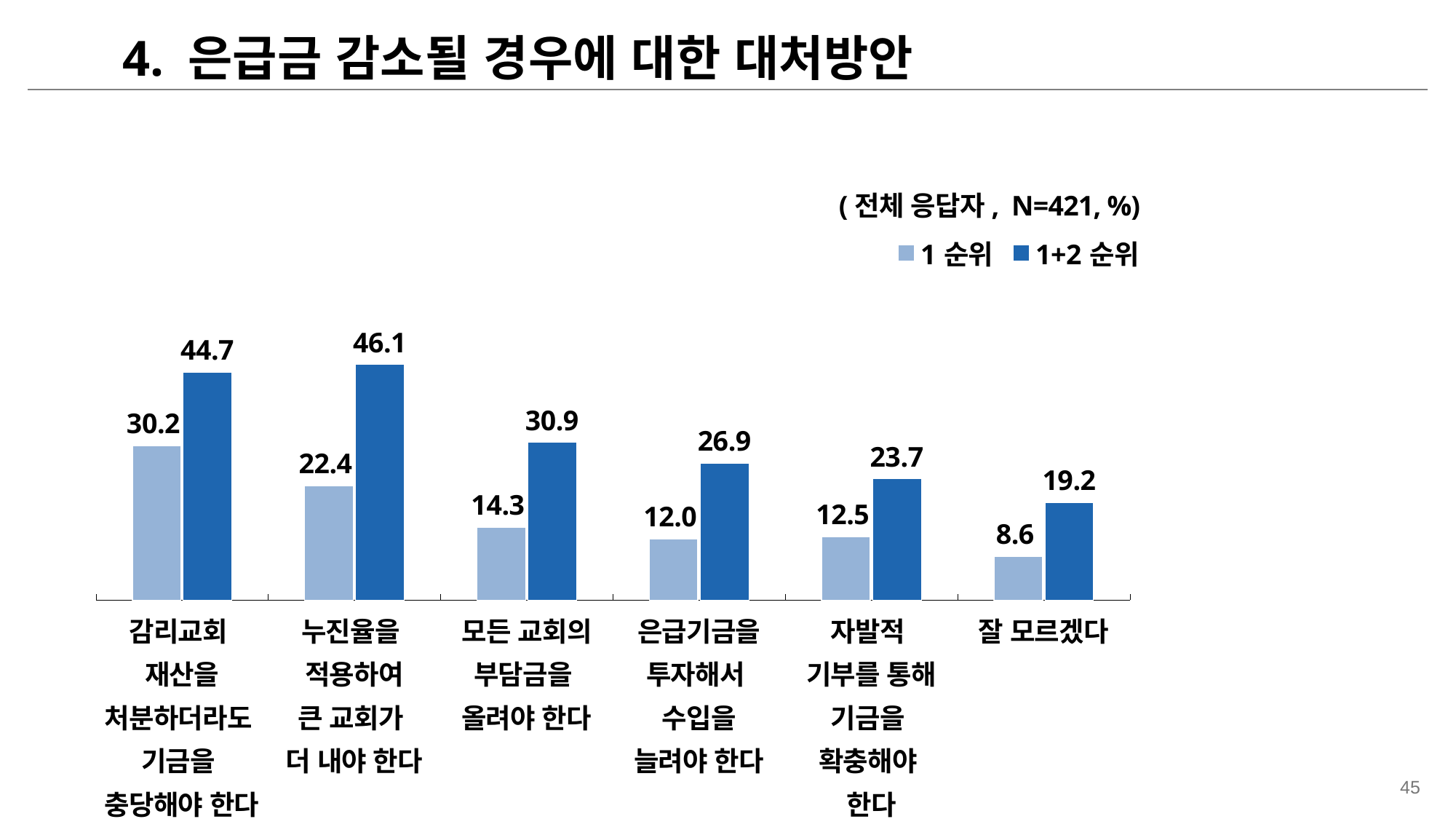
How many categories are shown on the x axis? 6 Which is larger: the 1+2 순위 value for 감리교회 재산을 처분하더라도 기금을 충당해야 한다 or for 누진율을 적용하여 큰 교회가 더 내야 한다? 누진율을 적용하여 큰 교회가 더 내야 한다 What type of chart is shown on the slide? bar chart What is the 1+2 순위 value for 누진율을 적용하여 큰 교회가 더 내야 한다? 46.1 What is the 1 순위 value for 잘 모르겠다? 8.6 Which category has the highest 1 순위 value? 감리교회 재산을 처분하더라도 기금을 충당해야 한다 What is the sample size (N) stated on the slide? 421 Which category has the lowest 1+2 순위 value? 잘 모르겠다 What is the 1 순위 value for 은급기금을 투자해서 수입을 늘려야 한다? 12.0 What is the difference between the 1+2 순위 and 1 순위 values for 모든 교회의 부담금을 올려야 한다? 16.6 What are the two legend entries of the chart? 1 순위, 1+2 순위 How many series does the legend list? 2